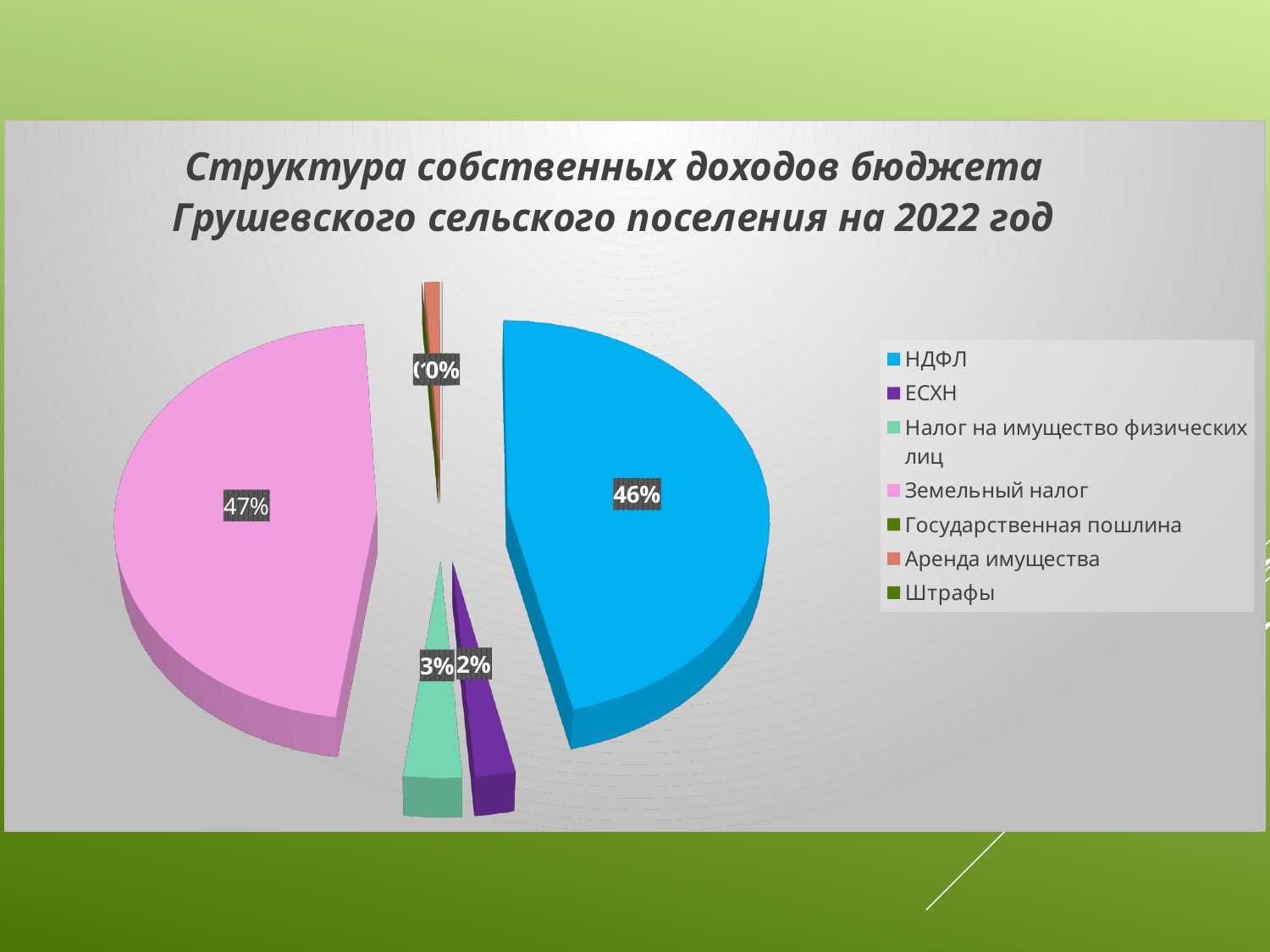
What share of the pie does ЕСХН account for? 2% How many categories does the legend list? 7 What is the title of the chart? Структура собственных доходов бюджета Грушевского сельского поселения на 2022 год Which is larger, the share for Земельный налог or the share for НДФЛ? Земельный налог Which is larger, the share for Налог на имущество физических лиц or the share for ЕСХН? Налог на имущество физических лиц What share of the pie does Земельный налог account for? 47% By how many percentage points does the share for НДФЛ exceed the share for Налог на имущество физических лиц? 43 What colour is the slice for НДФЛ? Blue What share of the pie does Налог на имущество физических лиц account for? 3% What share of the pie does НДФЛ account for? 46% Which category has the largest share of the pie? Земельный налог What kind of chart is shown on the slide? Pie chart